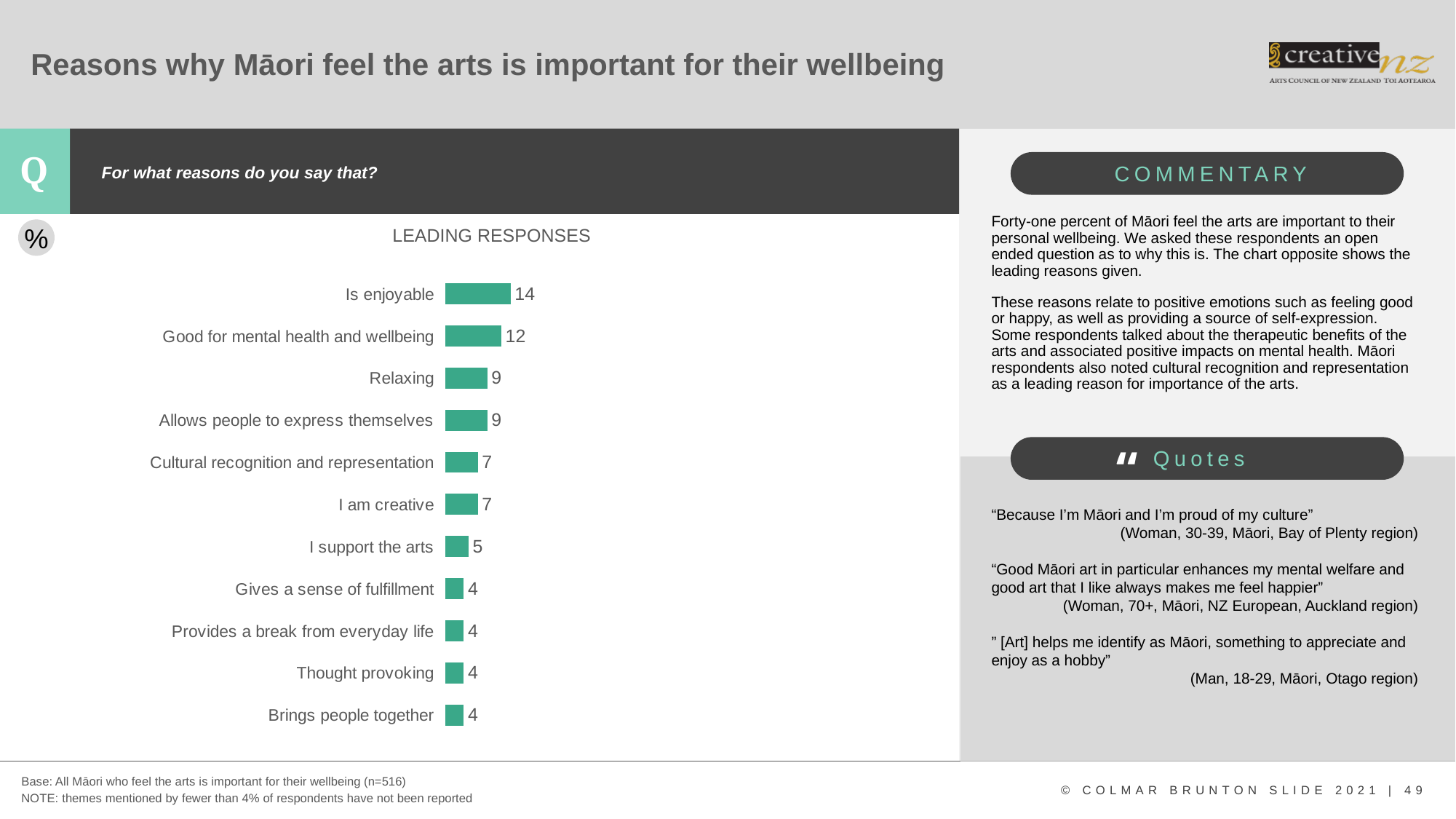
Which is larger, the value for "Relaxing" or the value for "I am creative"? Relaxing What is the value for "I support the arts"? 5 How many categories have a value of 4? 4 What is the value for "Cultural recognition and representation"? 7 Which category has the highest value? Is enjoyable What is the value for "Good for mental health and wellbeing"? 12 How many categories are shown in the chart? 11 What is the title of the chart? LEADING RESPONSES What is the difference between the values for "Relaxing" and "Brings people together"? 5 What is the difference between the values for "Is enjoyable" and "Good for mental health and wellbeing"? 2 What is the value for "Is enjoyable"? 14 What kind of chart is shown on the slide? Bar chart